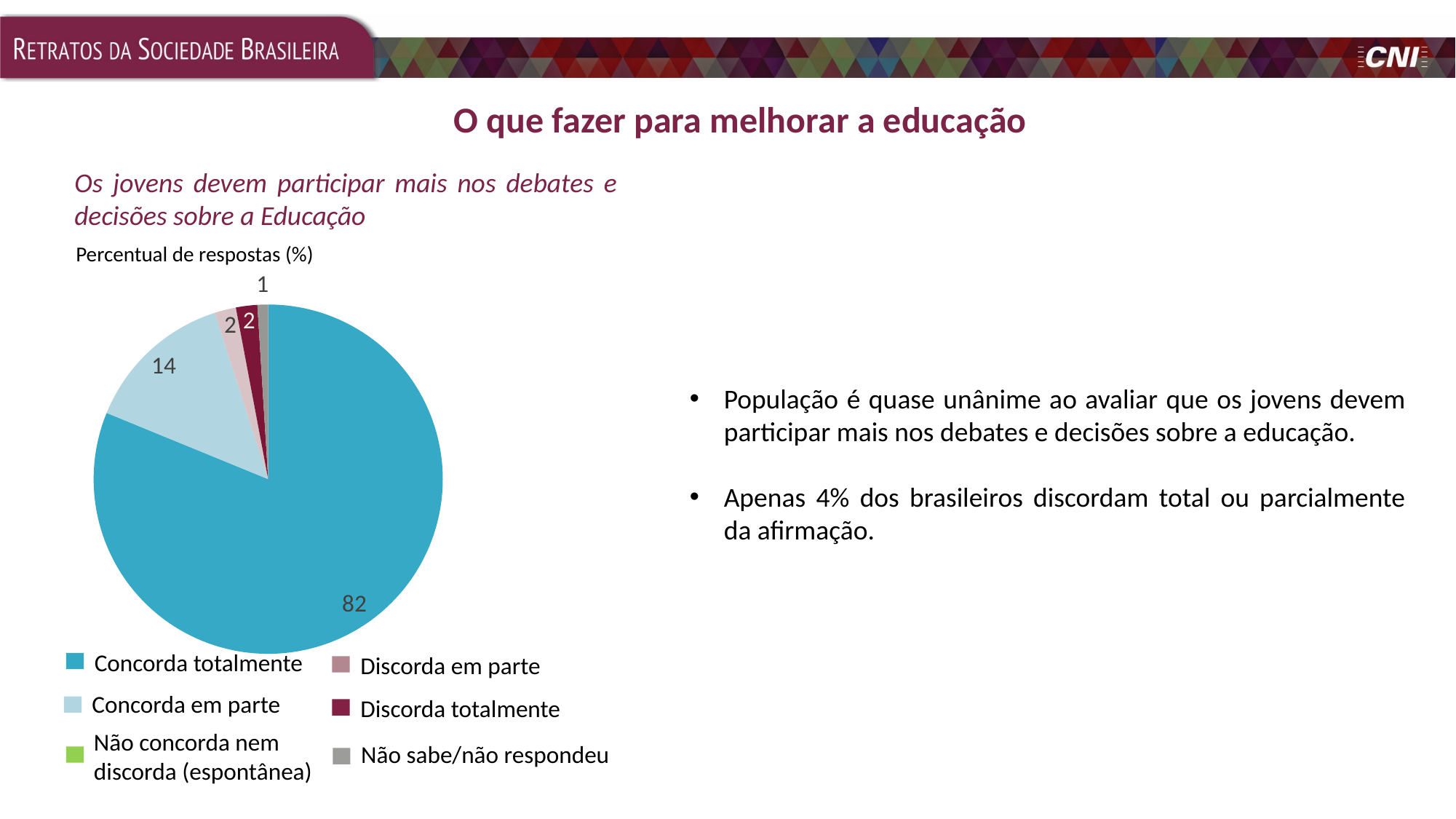
What is the combined value of "Discorda em parte" and "Discorda totalmente"? 4 What unit is indicated above the pie chart? Percentual de respostas (%) What is the value for "Concorda em parte" in the pie chart? 14 What type of chart is shown on the slide? pie chart What is the value for "Concorda totalmente" in the pie chart? 82 What is the difference between the values for "Concorda totalmente" and "Concorda em parte"? 68 What is the title of the pie chart? Os jovens devem participar mais nos debates e decisões sobre a Educação Which category has the largest slice in the pie chart? Concorda totalmente How many entries does the legend of the pie chart list? 6 Which is larger, the value for "Concorda em parte" or the value for "Discorda em parte"? Concorda em parte What is the value for "Discorda totalmente" in the pie chart? 2 What is the value for "Não sabe/não respondeu" in the pie chart? 1